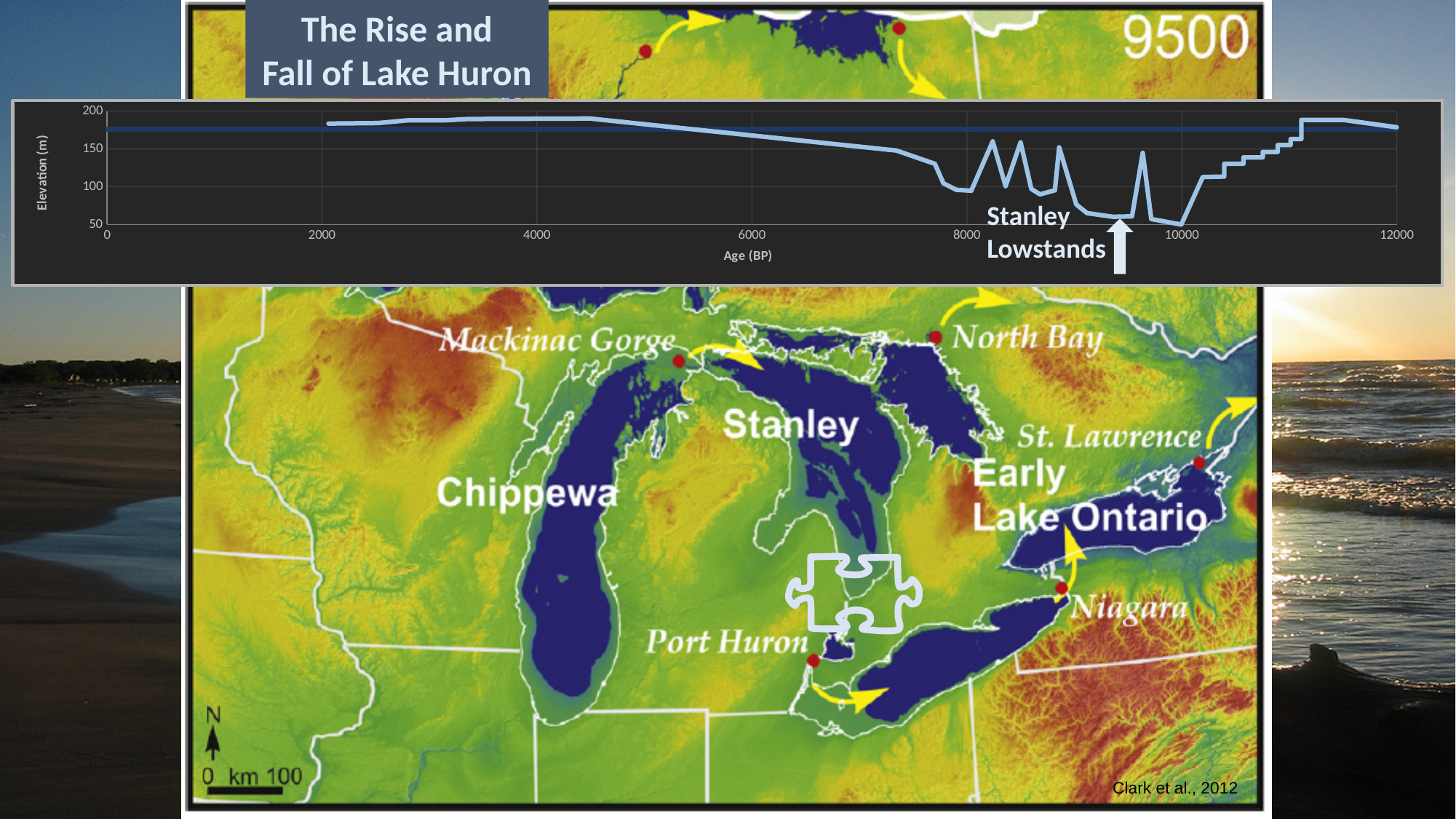
Between 4500 BP and 7500 BP, does the light blue line rise or fall as age increases? fall Is the elevation of the light blue line at 10000 BP greater or less than 100? less Between 10000 BP and 11000 BP, does the light blue line rise or fall as age increases? rise Is the elevation of the light blue line at 12000 BP greater or less than 150? greater Which has the higher elevation on the light blue line: 6000 BP or 10000 BP? 6000 BP Which has the higher elevation on the light blue line: 4000 BP or 10000 BP? 4000 BP What is the label of the vertical axis of the line chart? Elevation (m) What kind of chart is shown at the top of the slide? line chart What is the highest tick value shown on the vertical axis of the line chart? 200 What is the label of the horizontal axis of the line chart? Age (BP) Is the elevation of the light blue line at 6000 BP greater or less than 100? greater